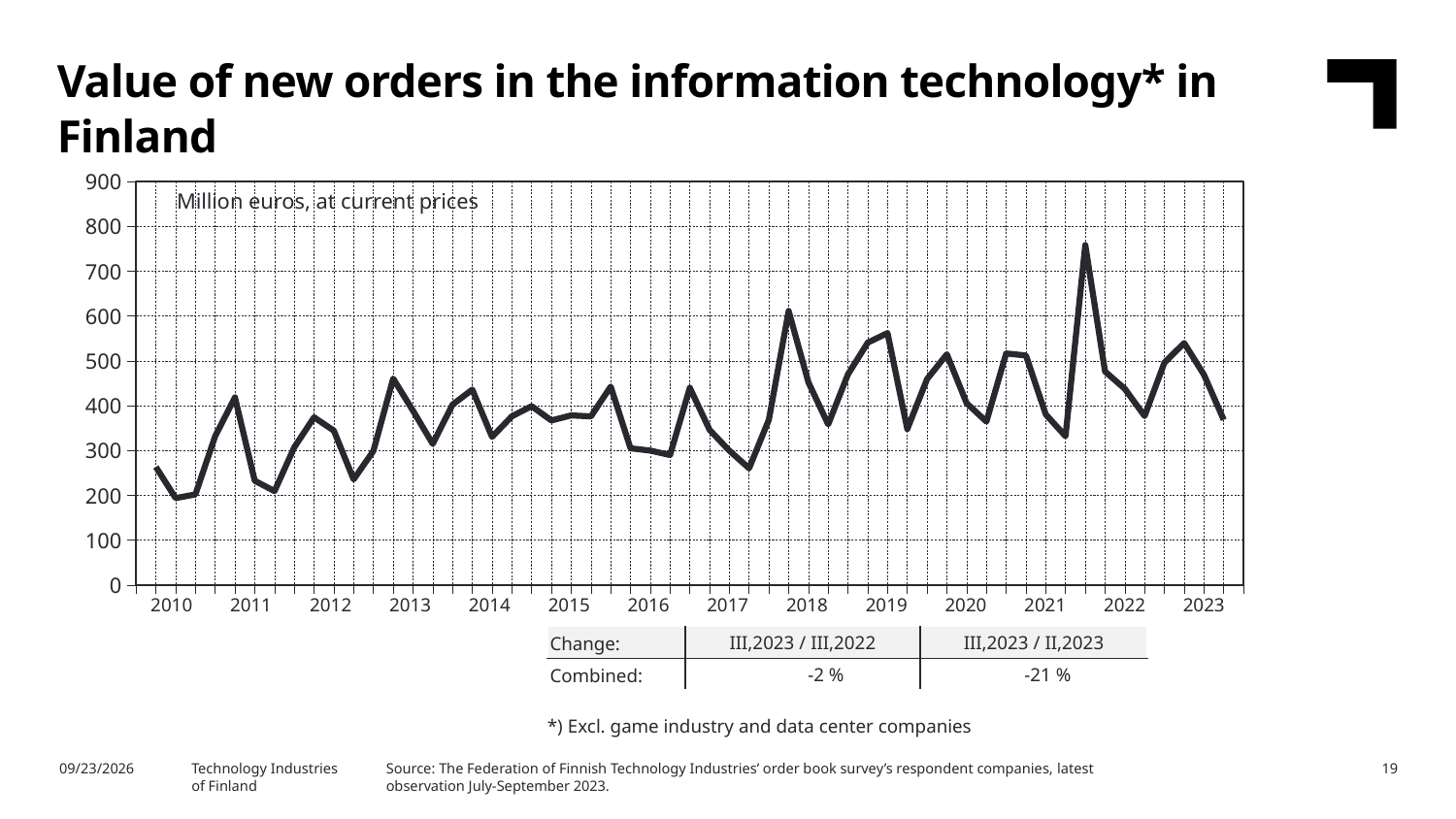
Is the low point of the line in 2017 greater or less than 300? less Is the highest peak of the line, in 2021, greater or less than 700? greater What is the combined change for III,2023 / II,2023 shown in the table below the chart? -21 % What kind of chart is shown on the slide? line chart Is the last plotted value, in 2023, greater or less than 400? less In which year does the line reach its highest peak? 2021 In what unit are the values on the chart expressed, according to the label inside the plot area? Million euros, at current prices Does the line rise or fall between the 2021 peak and the end of 2023? fall What is the title of the chart on the slide? Value of new orders in the information technology* in Finland How many year labels are shown on the x axis of the chart? 14